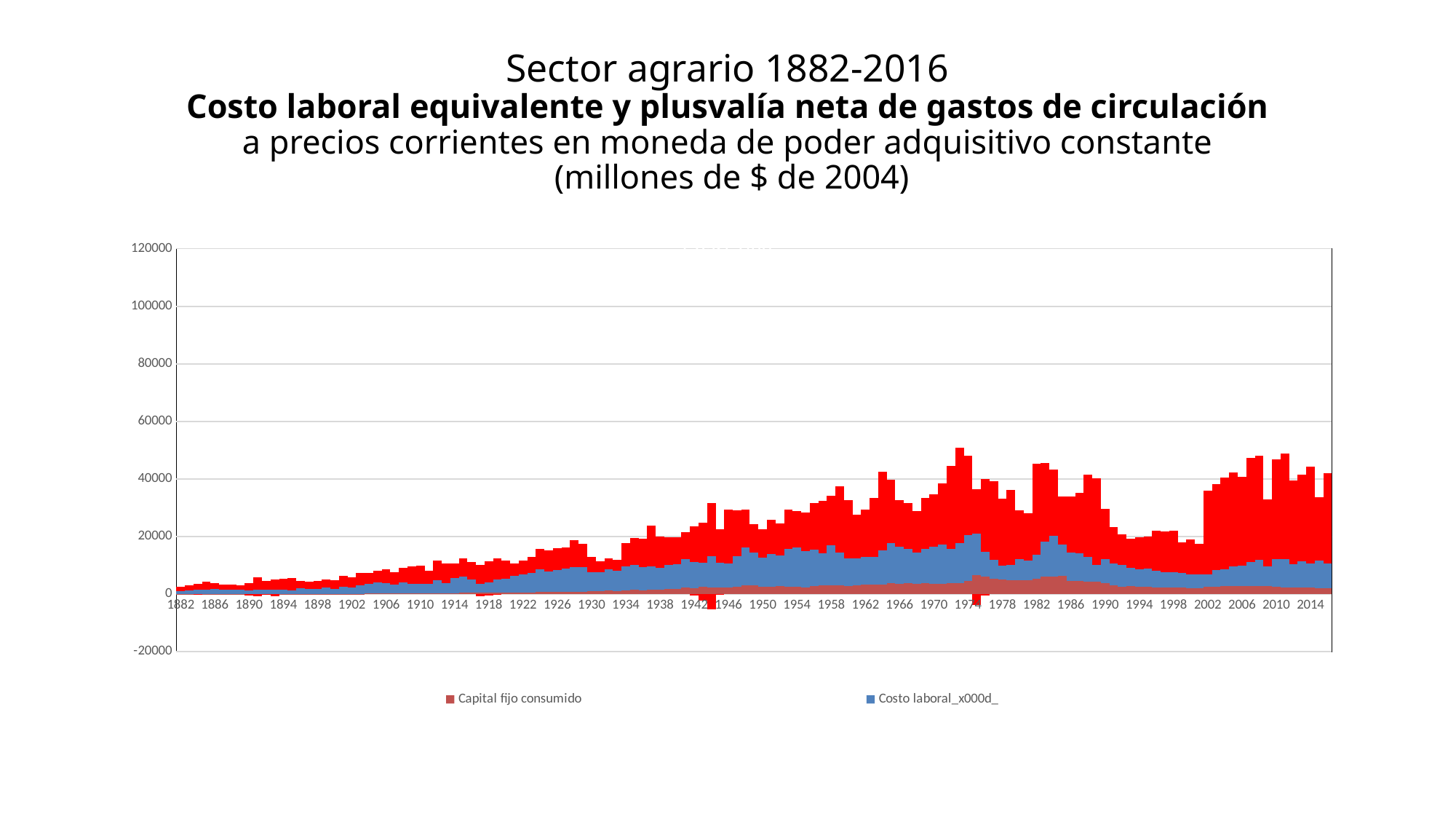
Is the Costo laboral_x000d_ value for 1910 greater or less than 20000? less How many series does the legend list? 2 Is the total stacked value for 1930 greater or less than 20000? less Is the total stacked value for 1882 greater or less than 20000? less Is the total stacked value for 2006 larger or smaller than the total for 1994? larger What kind of chart is shown on the slide? bar chart Overall, do the total stacked values rise or fall from 1882 to 2016? rise What are the two series named in the legend? Capital fijo consumido and Costo laboral_x000d_ What is the highest value shown on the vertical axis? 120000 What colour represents the Costo laboral_x000d_ series in the legend? blue